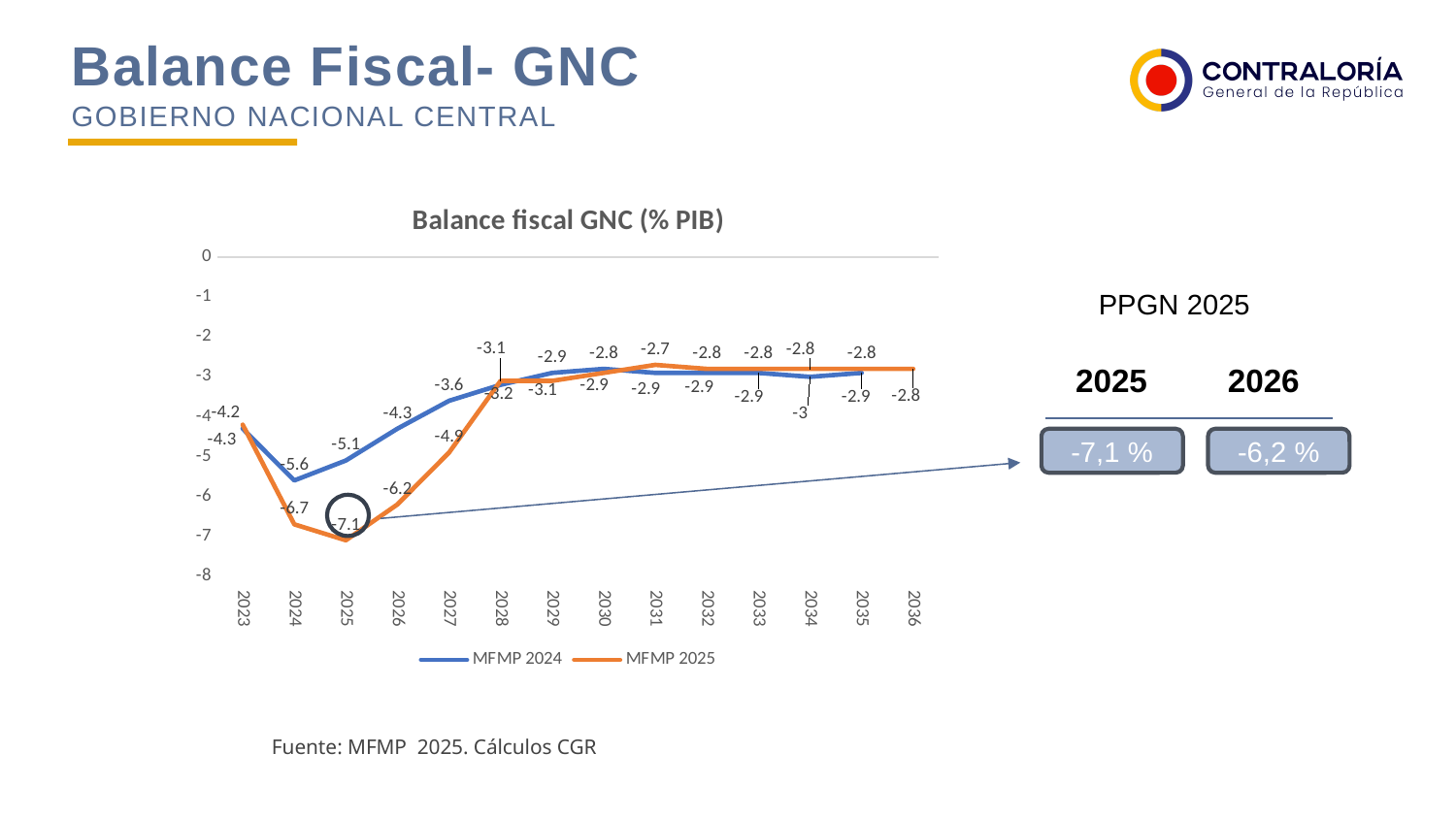
In which year does the MFMP 2025 series reach its lowest value? 2025 What are the two series named in the chart legend? MFMP 2024 and MFMP 2025 How many years are shown on the x axis of the chart? 14 Does the MFMP 2025 series rise or fall between 2025 and 2028? Rise What is the value of the MFMP 2024 series in 2024? -5.6 What is the value of the MFMP 2025 series in 2025? -7.1 What is the difference between the MFMP 2024 and MFMP 2025 values in 2025? 2.0 In 2026, which series has the lower value, MFMP 2024 or MFMP 2025? MFMP 2025 How many series does the legend of the chart list? 2 In which year does the MFMP 2024 series reach its lowest value? 2024 What kind of chart is shown on the slide? Line chart What is the value of the MFMP 2025 series in 2027? -4.9